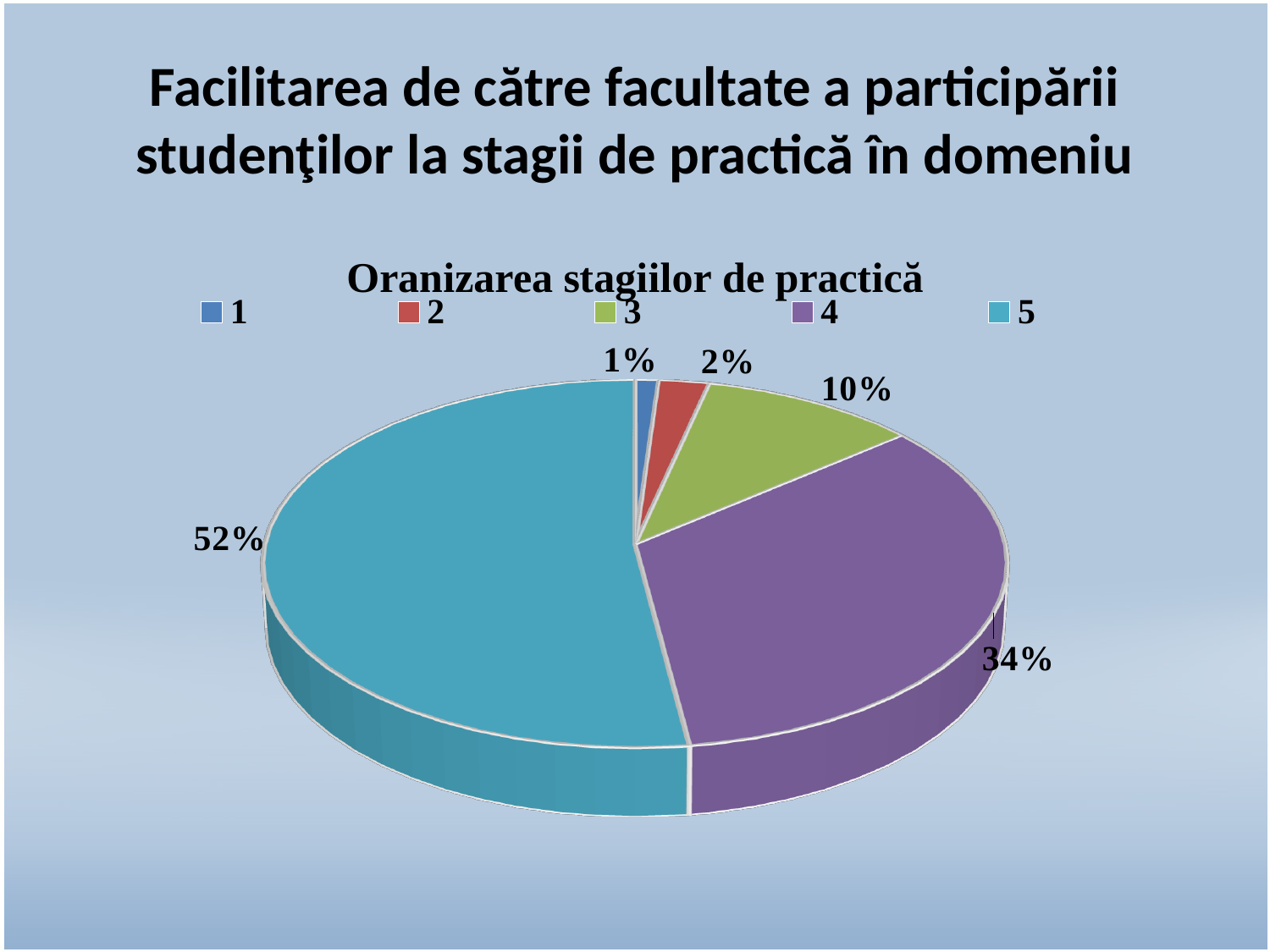
How many categories does the legend list? 5 Which category has the smallest slice? 1 What kind of chart is shown on the slide? pie chart What is the difference between the shares of category 5 and category 4? 18% What share of the pie does category 1 have? 1% What share of the pie does category 2 have? 2% What is the chart's title? Oranizarea stagiilor de practică Which category has the largest slice? 5 What share of the pie does category 4 have? 34% Which is larger, the share for category 3 or the share for category 2? 3